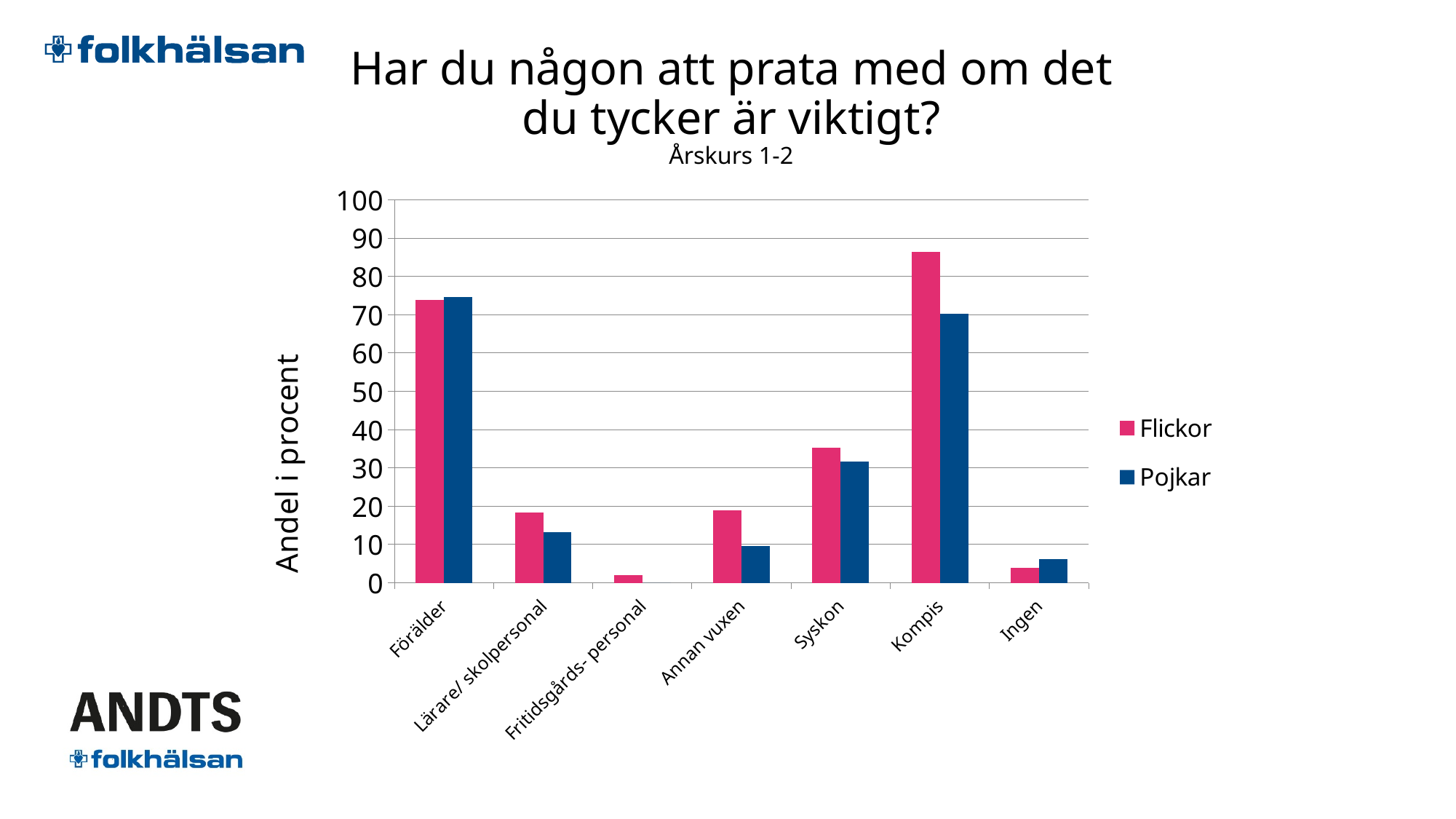
For which category is the Flickor value highest? Kompis For which category is the Flickor value lowest? Fritidsgårds- personal How many categories are shown on the x axis? 7 For Kompis, which series has the larger value, Flickor or Pojkar? Flickor What kind of chart is shown on the slide? bar chart Is the Flickor value for Syskon greater or less than 30? greater Is the Flickor value for Ingen greater or less than 10? less For which category is the Pojkar value highest? Förälder For Ingen, which series has the larger value, Flickor or Pojkar? Pojkar Is the Flickor value for Kompis greater or less than 80? greater How many series does the legend list? 2